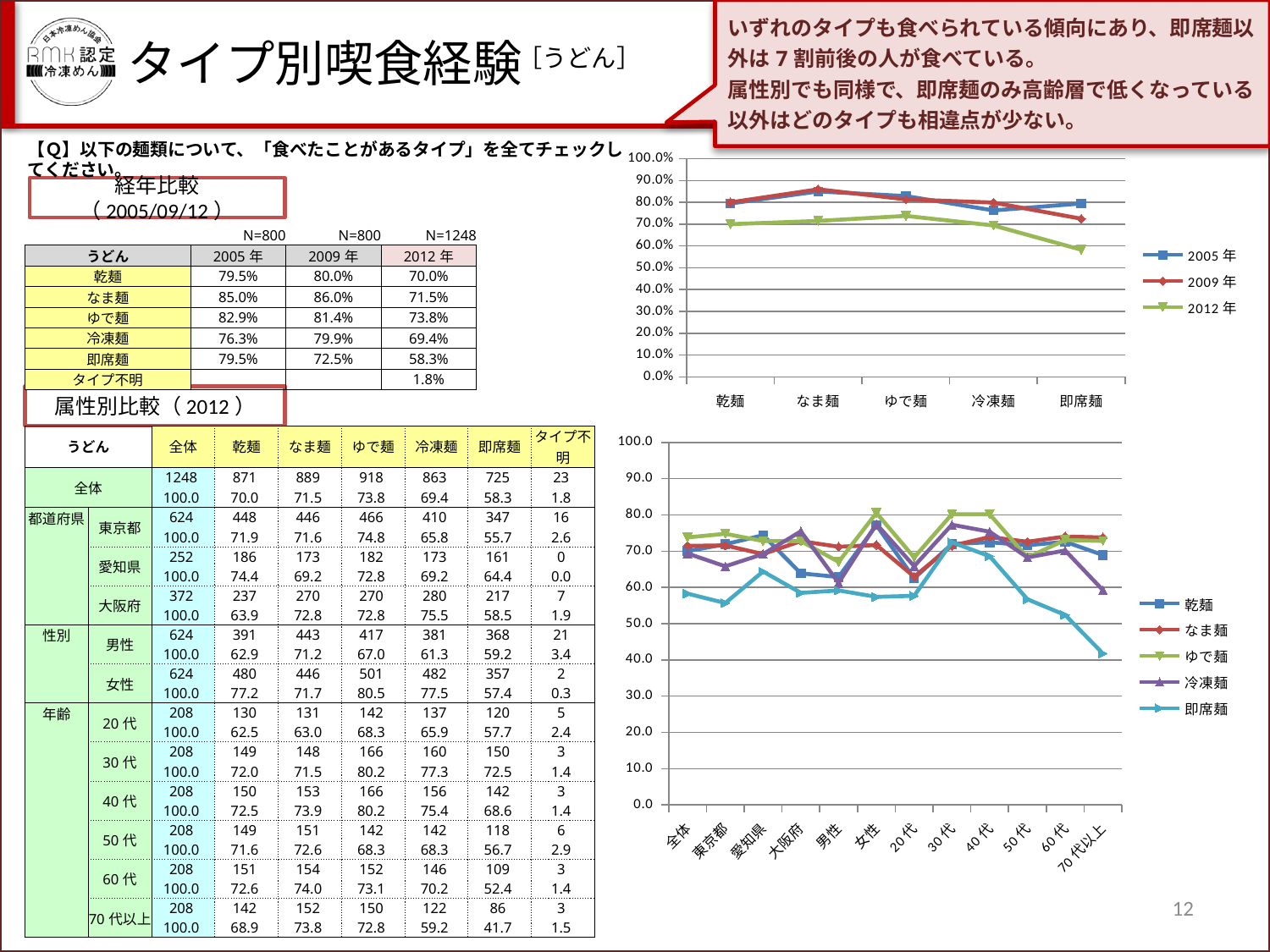
In the upper chart (経年比較), is the 2012年 value for 即席麺 greater or less than 70.0%? less In the lower chart (属性別比較 2012), how many categories are shown on the x axis? 12 In the lower chart (属性別比較 2012), how many series does the legend list? 5 In the upper chart (経年比較), how many series does the legend list? 3 In the upper chart (経年比較), how many categories are shown on the x axis? 5 In the upper chart (経年比較), which category has the lowest value for the 2012年 series? 即席麺 What type of chart is the upper chart (経年比較)? line chart What type of chart is the lower chart (属性別比較 2012)? line chart In the upper chart (経年比較), which category has the highest value for the 2009年 series? なま麺 In the upper chart (経年比較), what is the 2005年 value for 乾麺? 79.5% In the lower chart (属性別比較 2012), is the 即席麺 value for 70代以上 greater or less than 50.0? less In the lower chart (属性別比較 2012), at 女性, which is larger: ゆで麺 or 即席麺? ゆで麺